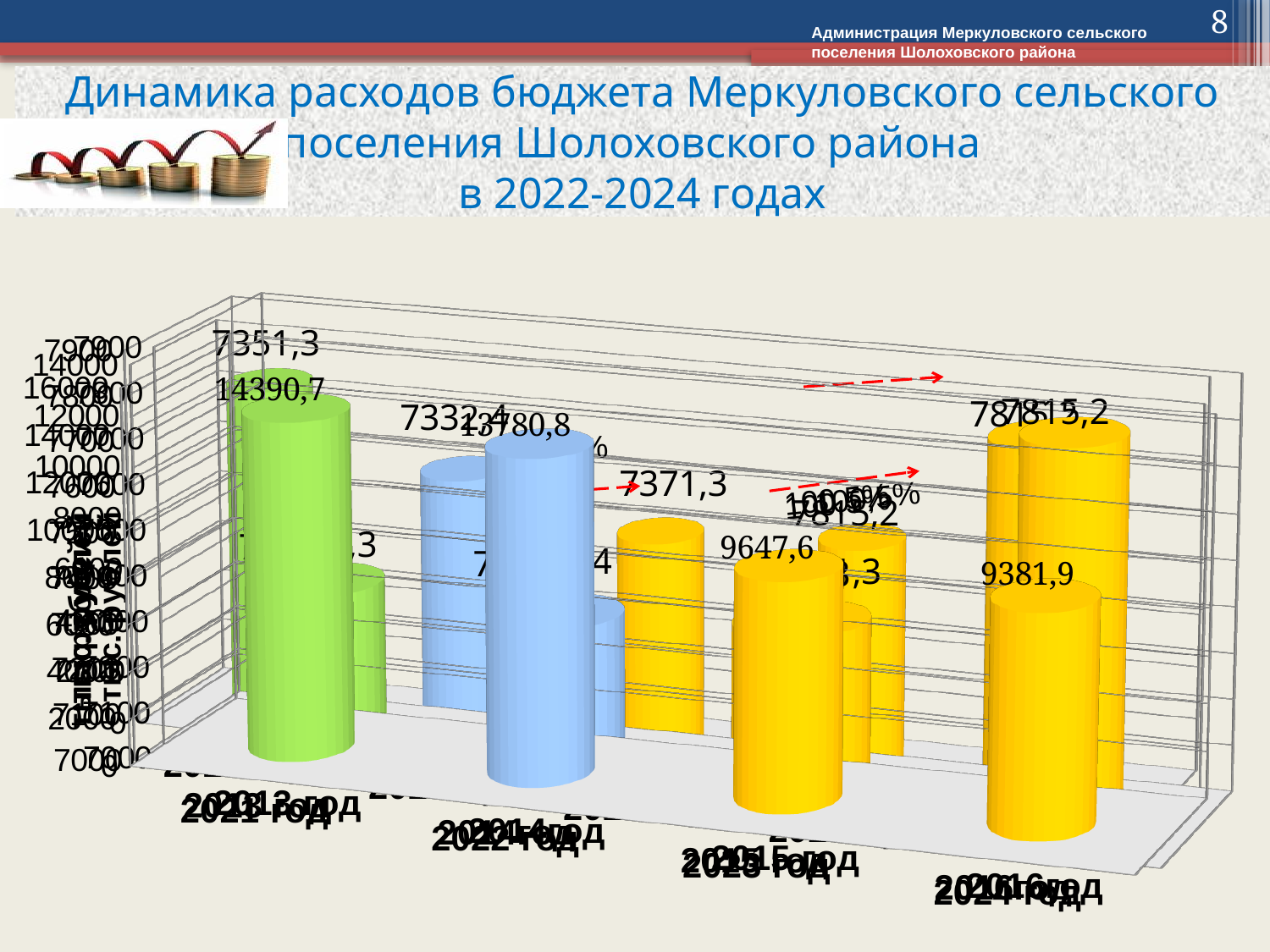
In the front chart (bold year labels), what is the difference between the values for 2021 год and 2024 год? 5008,8 What is the title of the slide's chart? Динамика расходов бюджета Меркуловского сельского поселения Шолоховского района в 2022-2024 годах In the front chart (bold year labels), which is larger: the value for 2022 год or 2023 год? 2022 год In the front chart (bold year labels), which year has the highest value? 2021 год In the front chart (bold year labels), what is the difference between the values for 2021 год and 2022 год? 609,9 In the front chart (bold year labels), what is the value for 2023 год? 9647,6 In the front chart (bold year labels), which year has the lowest value? 2024 год In the front chart (bold year labels), what is the value for 2022 год? 13780,8 What kind of chart is shown on the slide? bar chart In the front chart (bold year labels), do the values rise or fall from 2021 год to 2024 год? fall In the front chart (bold year labels), what is the value for 2024 год? 9381,9 In the front chart (bold year labels), what is the value for 2021 год? 14390,7